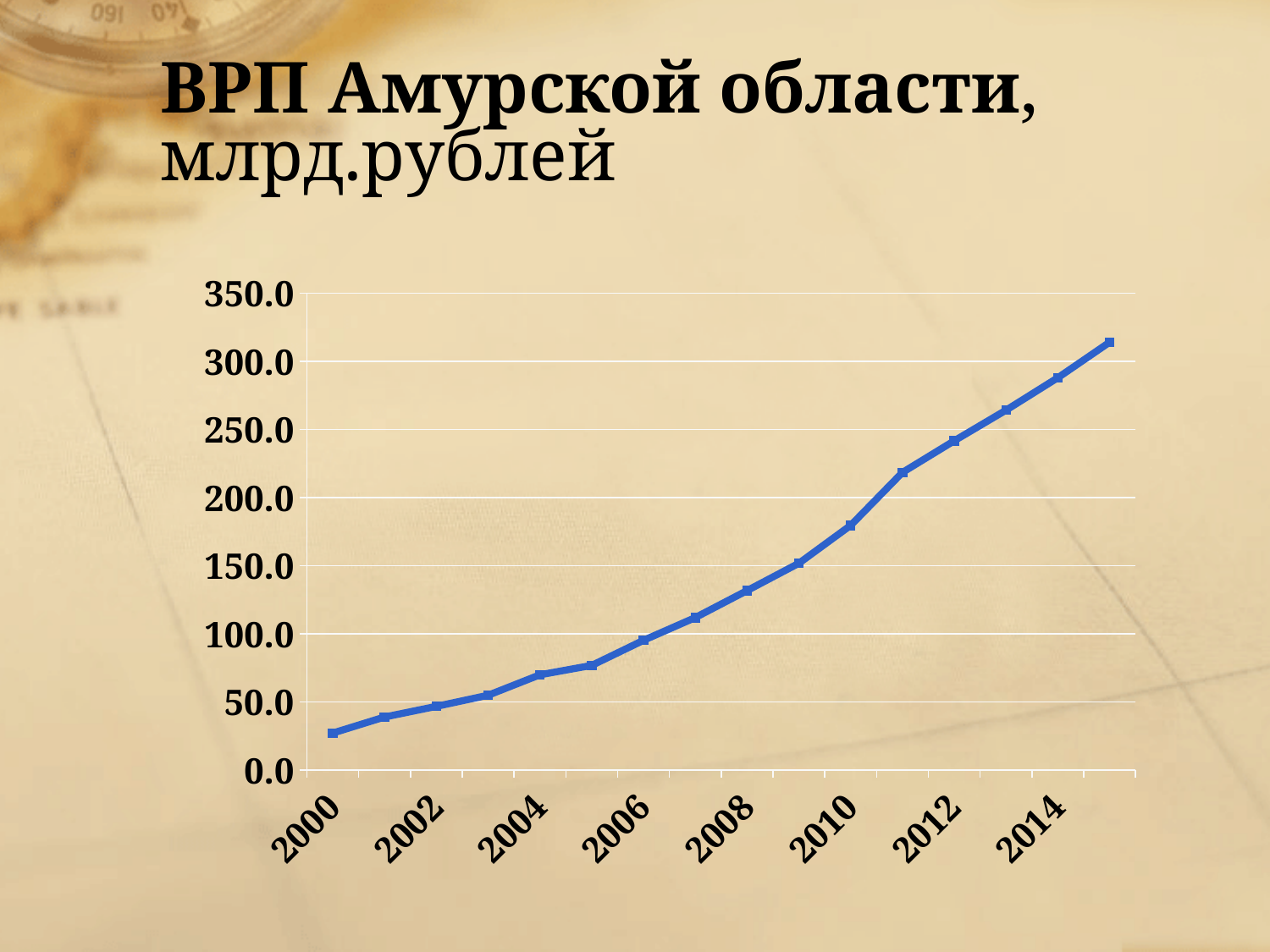
What is the title of the chart? ВРП Амурской области, млрд.рублей Which year has the lowest value on the chart? 2000 Is the value for 2012 greater or less than 200.0? greater Is the value for 2000 greater or less than 50.0? less What kind of chart is shown on the slide? line chart Do the values rise or fall from 2000 to the last year on the x axis? rise Is the value for 2010 greater or less than 150.0? greater Which year has the highest value on the chart? 2015 How many data points are plotted on the line? 16 Which year has the larger value, 2006 or 2010? 2010